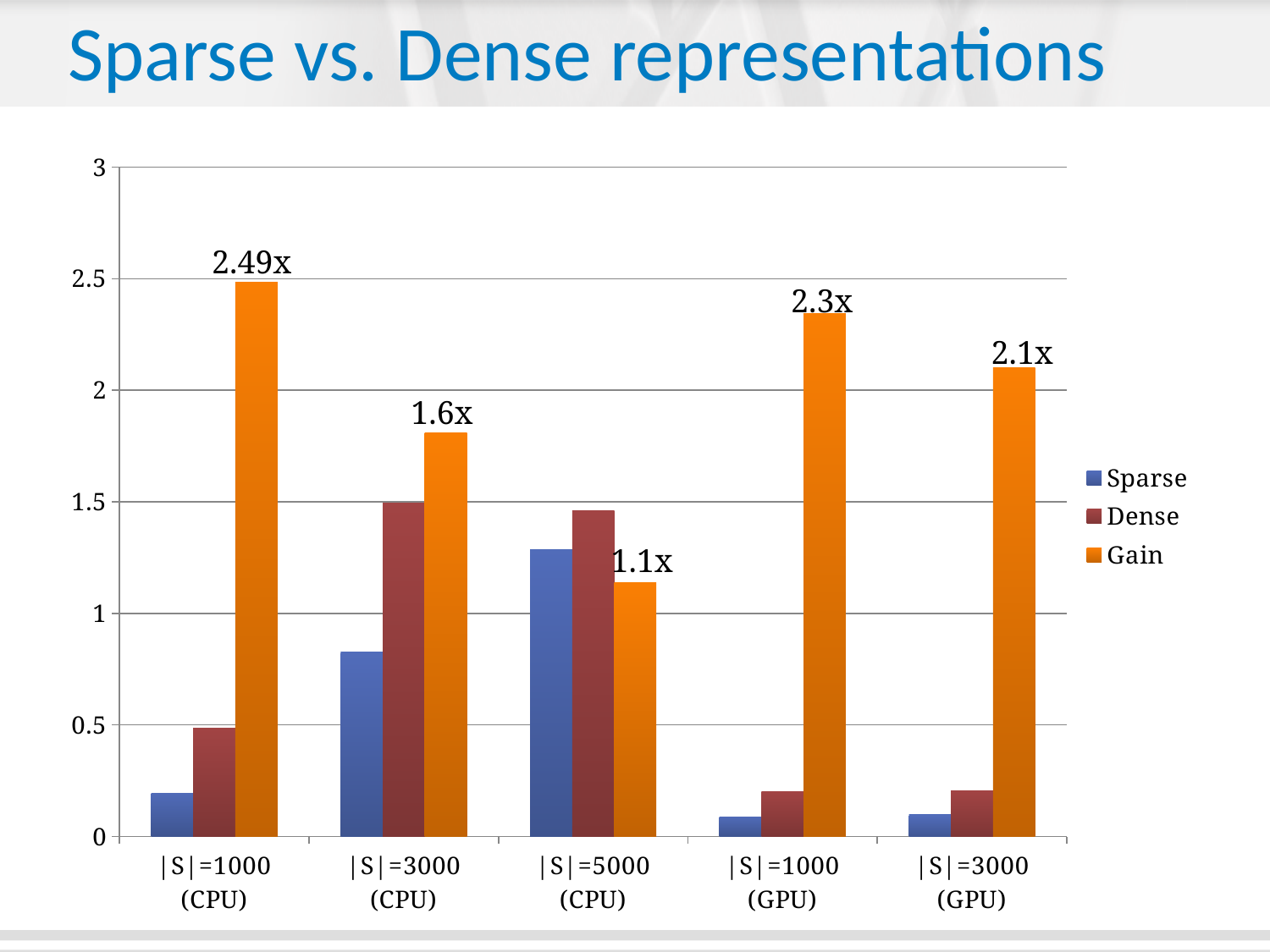
Which category has the highest Gain value? |S|=1000 (CPU) Which has the larger Gain value, |S|=1000 (GPU) or |S|=3000 (GPU)? |S|=1000 (GPU) What is the Gain value labelled for |S|=5000 (CPU)? 1.1x For |S|=5000 (CPU), which bar is taller, Sparse or Dense? Dense What is the Gain value labelled for |S|=1000 (CPU)? 2.49x Is the Sparse value for |S|=5000 (CPU) greater or less than 1? greater Is the Sparse value for |S|=1000 (CPU) greater or less than 0.5? less Which category has the lowest Gain value? |S|=5000 (CPU) How many series does the legend list? 3 What kind of chart is shown on the slide? Bar chart How many categories are shown on the x axis? 5 What is the Gain value labelled for |S|=3000 (GPU)? 2.1x